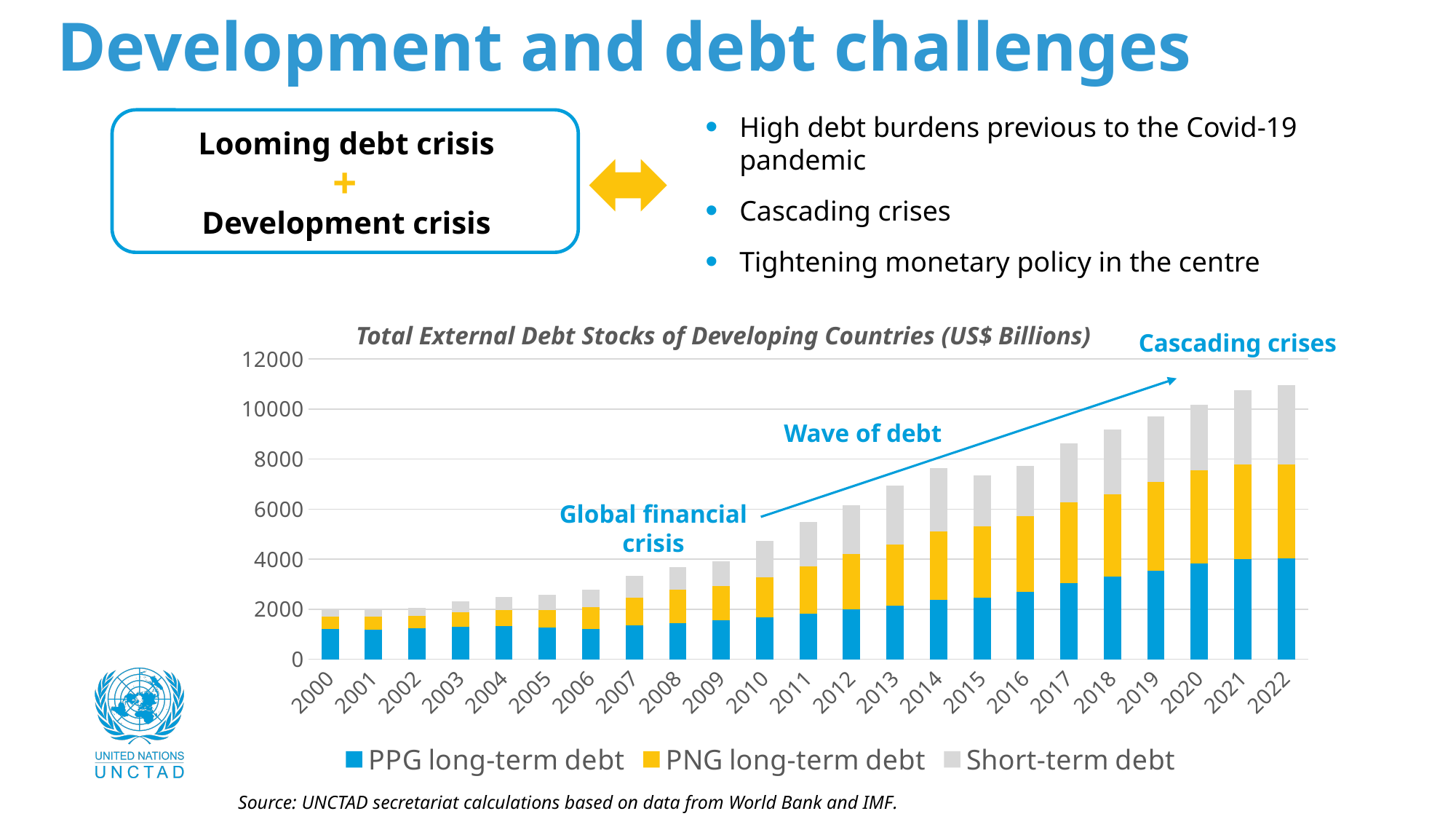
What kind of chart is shown on the slide? Stacked bar chart How many series does the chart legend list? 3 Is the total external debt stock for 2015 greater or less than 8000? less What is the title of the chart? Total External Debt Stocks of Developing Countries (US$ Billions) Is the total external debt stock for 2010 greater or less than 6000? less Which colour represents Short-term debt in the chart? Grey Which year has the highest total external debt stock in the chart? 2022 Which year has the larger total external debt stock, 2010 or 2022? 2022 Do total external debt stocks generally rise or fall from 2000 to 2022? Rise How many years are plotted along the x axis of the chart? 23 Is the total external debt stock for 2000 greater or less than 4000? less